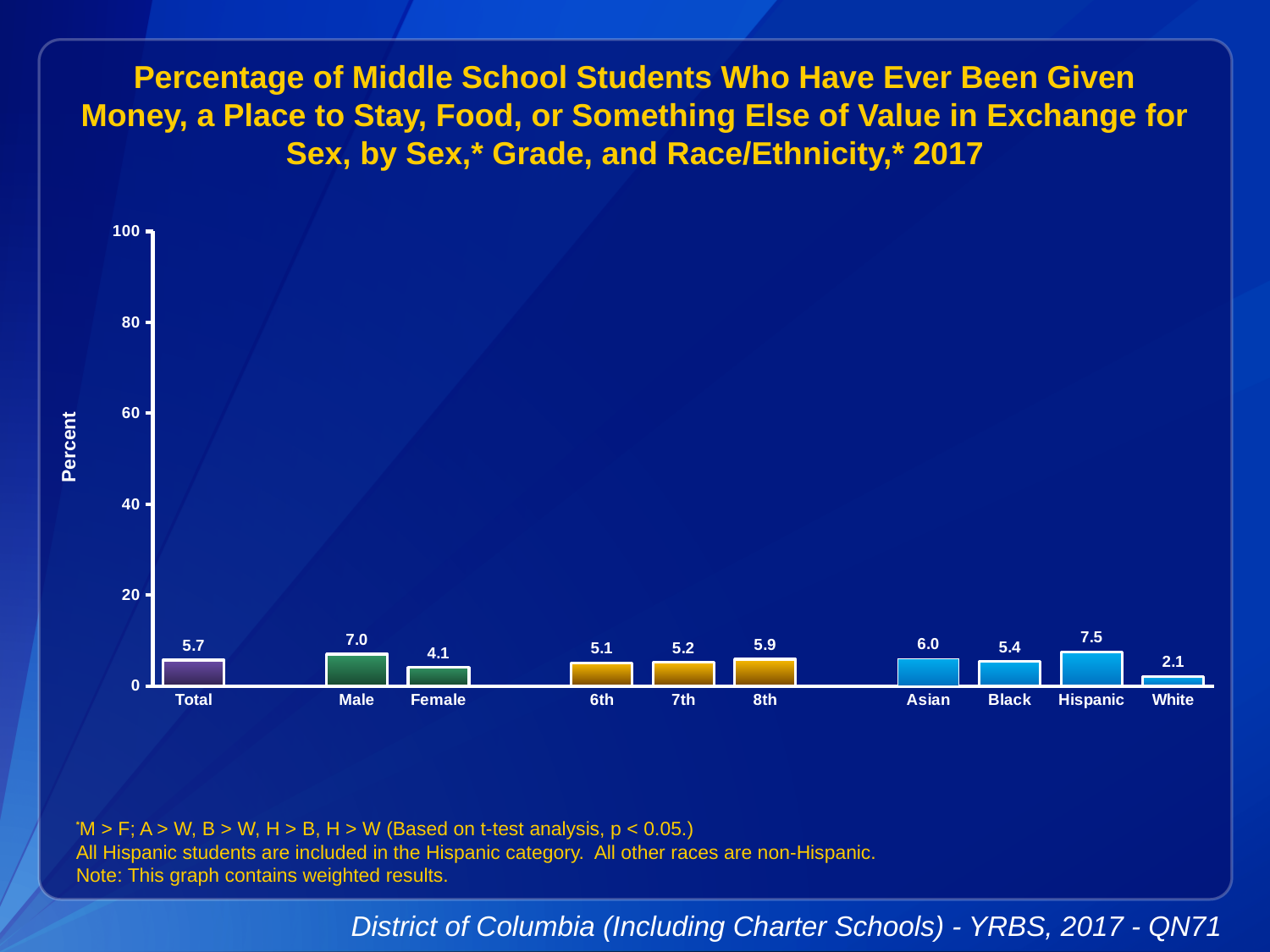
How many categories are shown on the x axis? 10 What is the value for Male? 7.0 What is the difference between the values for Male and Female? 2.9 What kind of chart is this? bar chart Which category has the highest value? Hispanic Do the values rise or fall from 6th to 8th grade? rise What is the value for White? 2.1 Is the value for 8th greater or less than 20? less Which category has the lowest value? White Which is larger, the value for Asian or the value for Black? Asian What is the label on the y axis? Percent What is the value for Total? 5.7